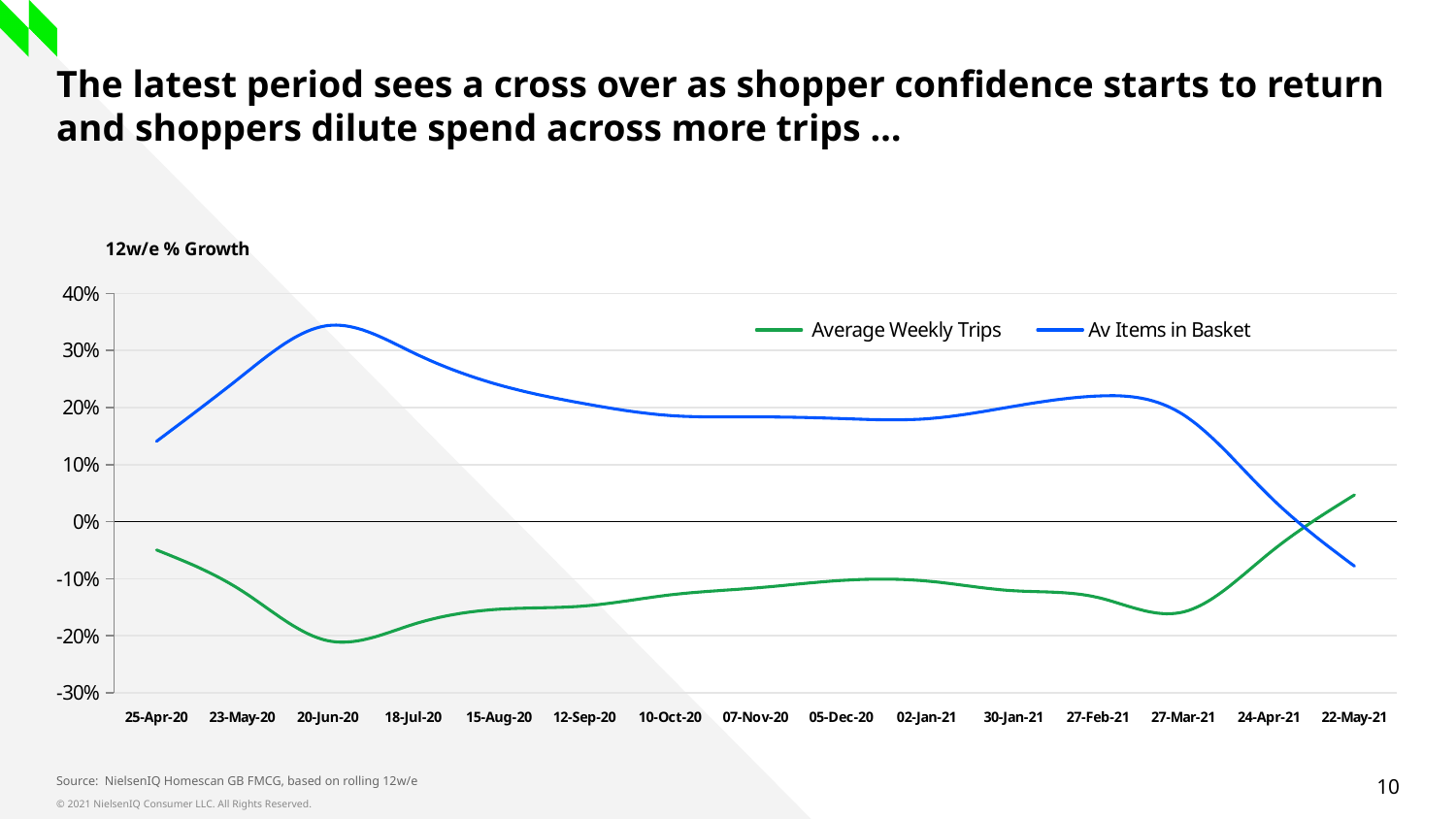
Is the value for Av Items in Basket at 22-May-21 greater or less than 0%? less Does the Av Items in Basket line rise or fall between 27-Feb-21 and 22-May-21? fall What kind of chart is shown on the slide? line chart What is the title shown above the chart? 12w/e % Growth How many series does the legend list? 2 Is the value for Average Weekly Trips at 20-Jun-20 greater or less than -10%? less At 22-May-21, which series has the higher value, Average Weekly Trips or Av Items in Basket? Average Weekly Trips At which date does the Average Weekly Trips line reach its lowest value? 20-Jun-20 At which date does the Av Items in Basket line reach its highest value? 20-Jun-20 How many dates are shown along the x axis? 15 Which series is drawn in blue? Av Items in Basket Is the value for Av Items in Basket at 20-Jun-20 greater or less than 30%? greater